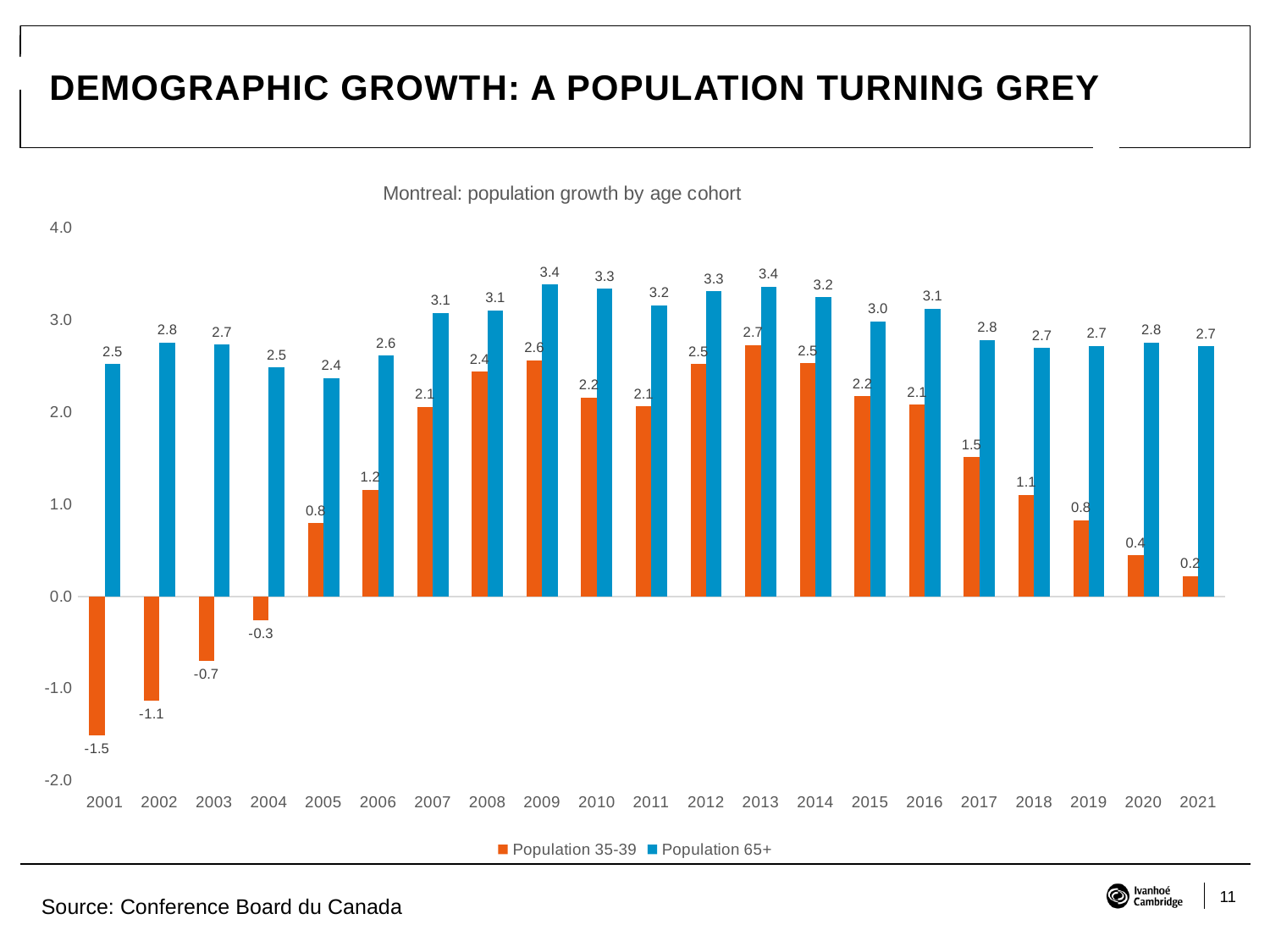
What is the value for Population 35-39 in 2021? 0.2 What kind of chart is shown on the slide? Bar chart What is the difference between Population 65+ and Population 35-39 in 2017? 1.3 What is the value for Population 65+ in 2009? 3.4 In which year is the Population 35-39 value highest? 2013 In which year is the Population 65+ value lowest? 2005 Is the value for Population 65+ in 2010 greater or less than 3.0? greater Does the Population 35-39 value rise or fall from 2013 to 2021? Fall Which is larger in 2013: Population 35-39 or Population 65+? Population 65+ How many series does the legend list? 2 How many years are shown on the x axis? 21 What is the value for Population 35-39 in 2001? -1.5